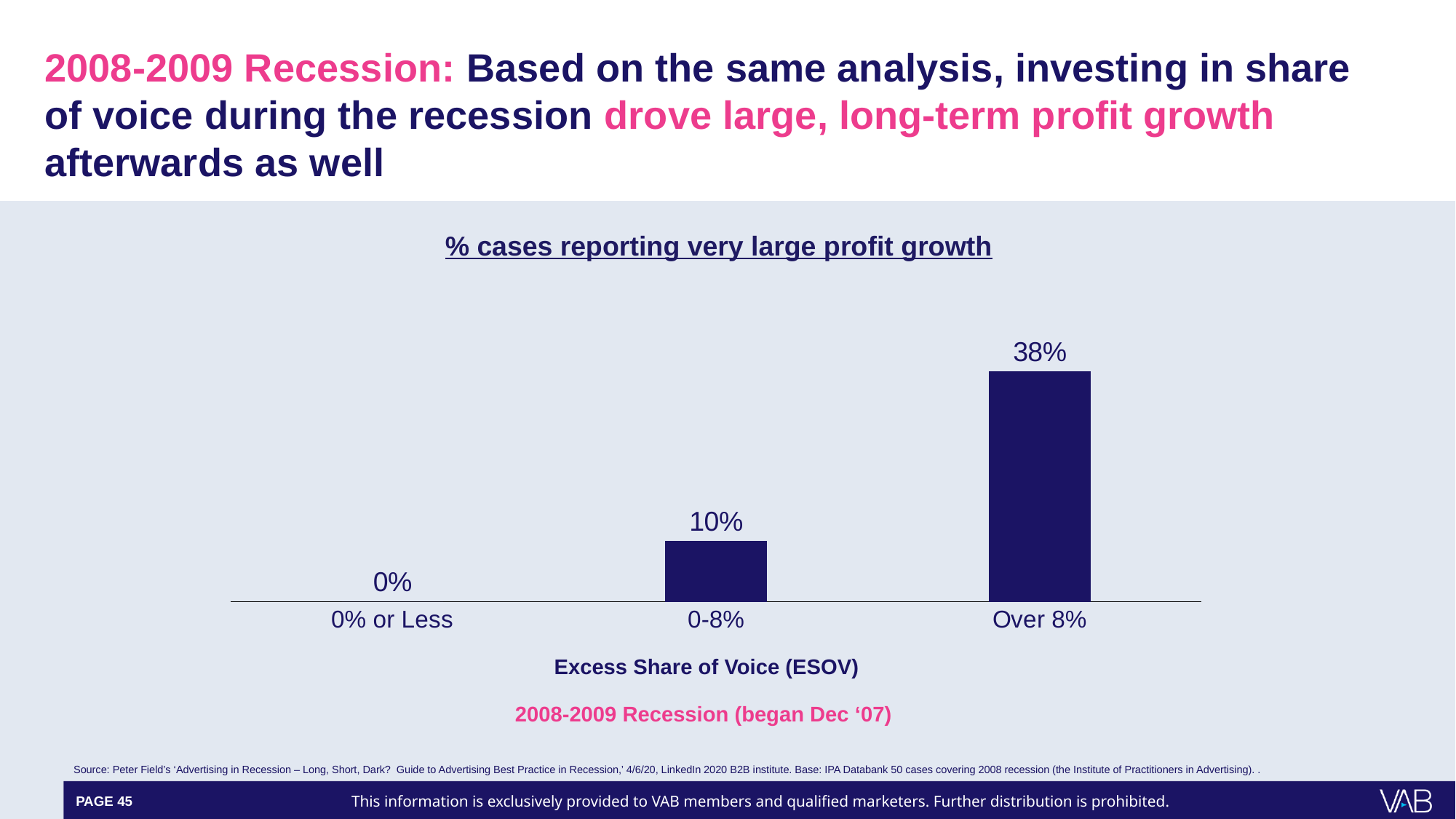
Which category has a larger value: '0-8%' or 'Over 8%'? Over 8% Which ESOV category has the highest percentage of cases reporting very large profit growth? Over 8% What percentage of cases reported very large profit growth for the '0-8%' ESOV category? 10% What is the label of the x axis? Excess Share of Voice (ESOV) Do the values rise or fall moving from left to right along the x axis? Rise What percentage of cases reported very large profit growth for the 'Over 8%' ESOV category? 38% What is the difference in percentage points between the 'Over 8%' and '0-8%' categories? 28 percentage points What is the title of the chart? % cases reporting very large profit growth What type of chart is shown on the slide? Bar chart Which ESOV category has the lowest percentage of cases reporting very large profit growth? 0% or Less How many ESOV categories are shown on the chart? 3 What percentage of cases reported very large profit growth for the '0% or Less' ESOV category? 0%